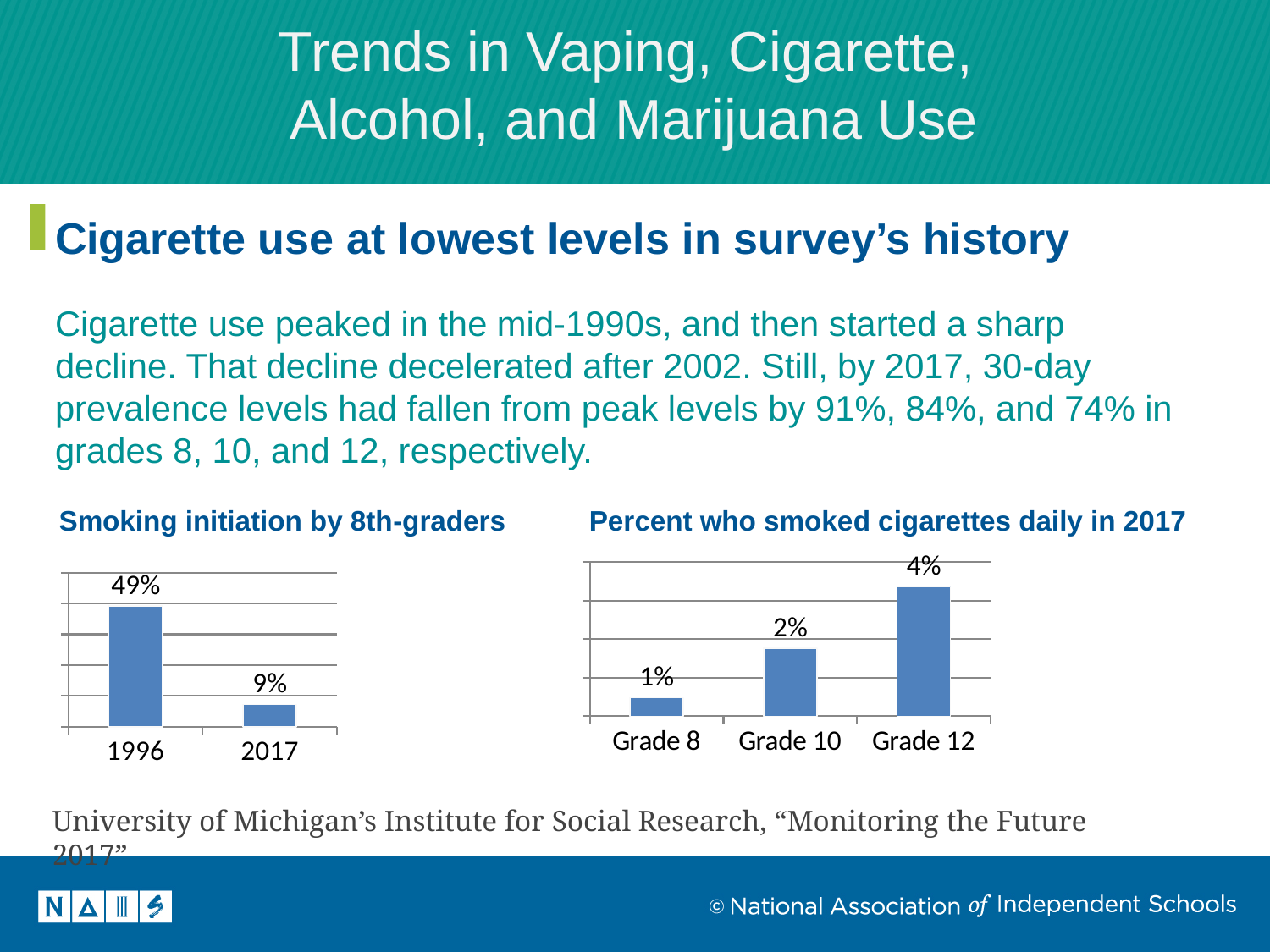
In the 'Smoking initiation by 8th-graders' chart, how many categories are shown? 2 In the 'Smoking initiation by 8th-graders' chart, what is the value for 2017? 9% In the 'Percent who smoked cigarettes daily in 2017' chart, which grade has the highest value? Grade 12 In the 'Smoking initiation by 8th-graders' chart, what is the value for 1996? 49% In the 'Smoking initiation by 8th-graders' chart, do the values rise or fall from 1996 to 2017? fall In the 'Percent who smoked cigarettes daily in 2017' chart, how many grades are shown? 3 What kind of chart is 'Smoking initiation by 8th-graders'? bar chart In the 'Percent who smoked cigarettes daily in 2017' chart, what is the value for Grade 10? 2% In the 'Smoking initiation by 8th-graders' chart, what is the difference between the 1996 and 2017 values? 40% In the 'Percent who smoked cigarettes daily in 2017' chart, what is the difference between the Grade 12 and Grade 8 values? 3% In the 'Percent who smoked cigarettes daily in 2017' chart, which grade has the lowest value? Grade 8 In the 'Percent who smoked cigarettes daily in 2017' chart, do the values rise or fall from Grade 8 to Grade 12? rise